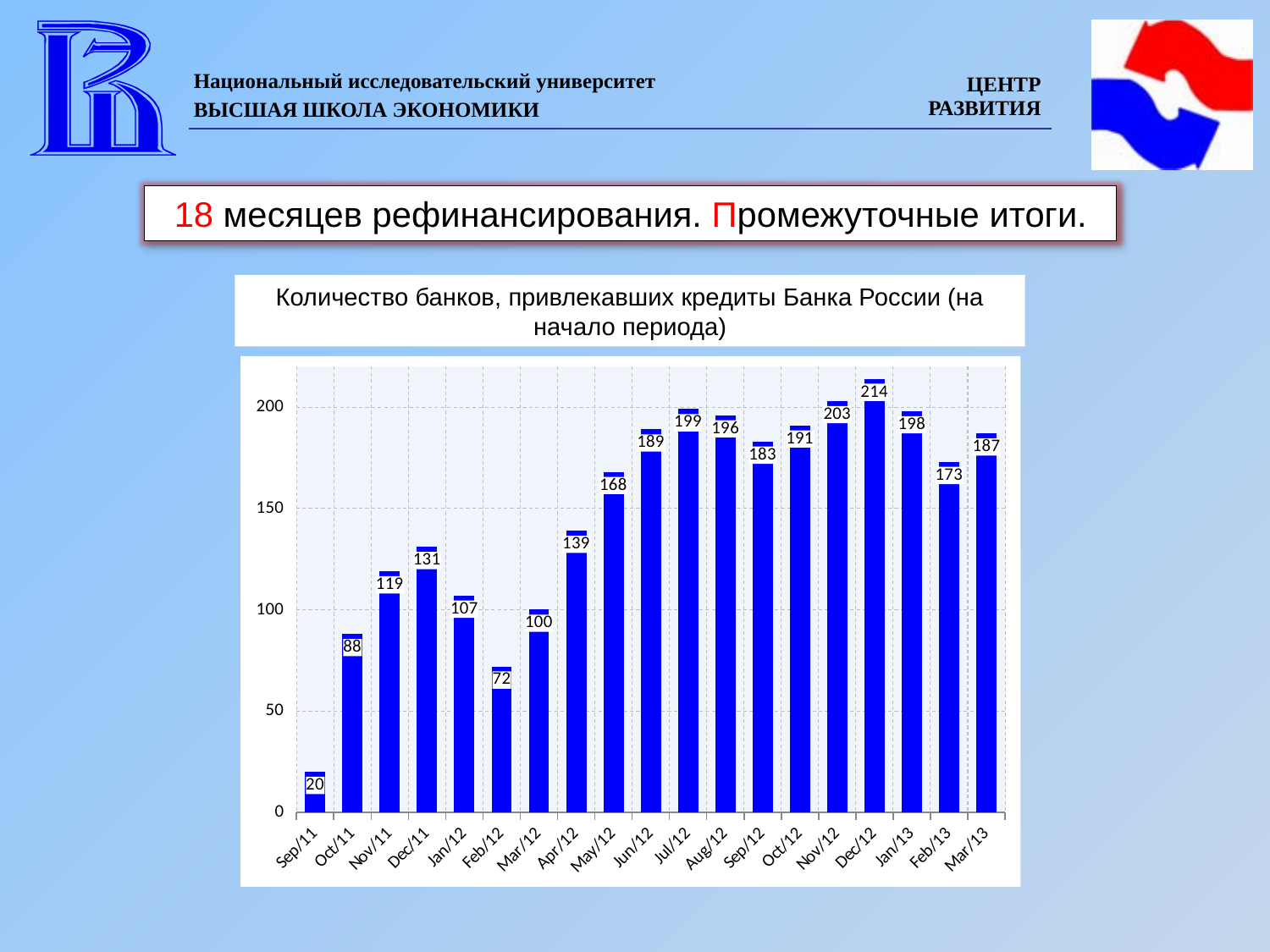
How many months are shown on the x axis? 19 What is the value for Dec/12? 214 Which month has the lowest value? Sep/11 What is the title of the chart? Количество банков, привлекавших кредиты Банка России (на начало периода) Is the value for Nov/12 greater or less than 200? greater Which month has the highest value? Dec/12 What kind of chart is shown on the slide? bar chart Which is larger, the value for Jul/12 or the value for Aug/12? Jul/12 What is the value for Feb/12? 72 What is the value for May/12? 168 What is the difference between the values for Mar/13 and Feb/13? 14 What is the difference between the values for Dec/12 and Sep/11? 194